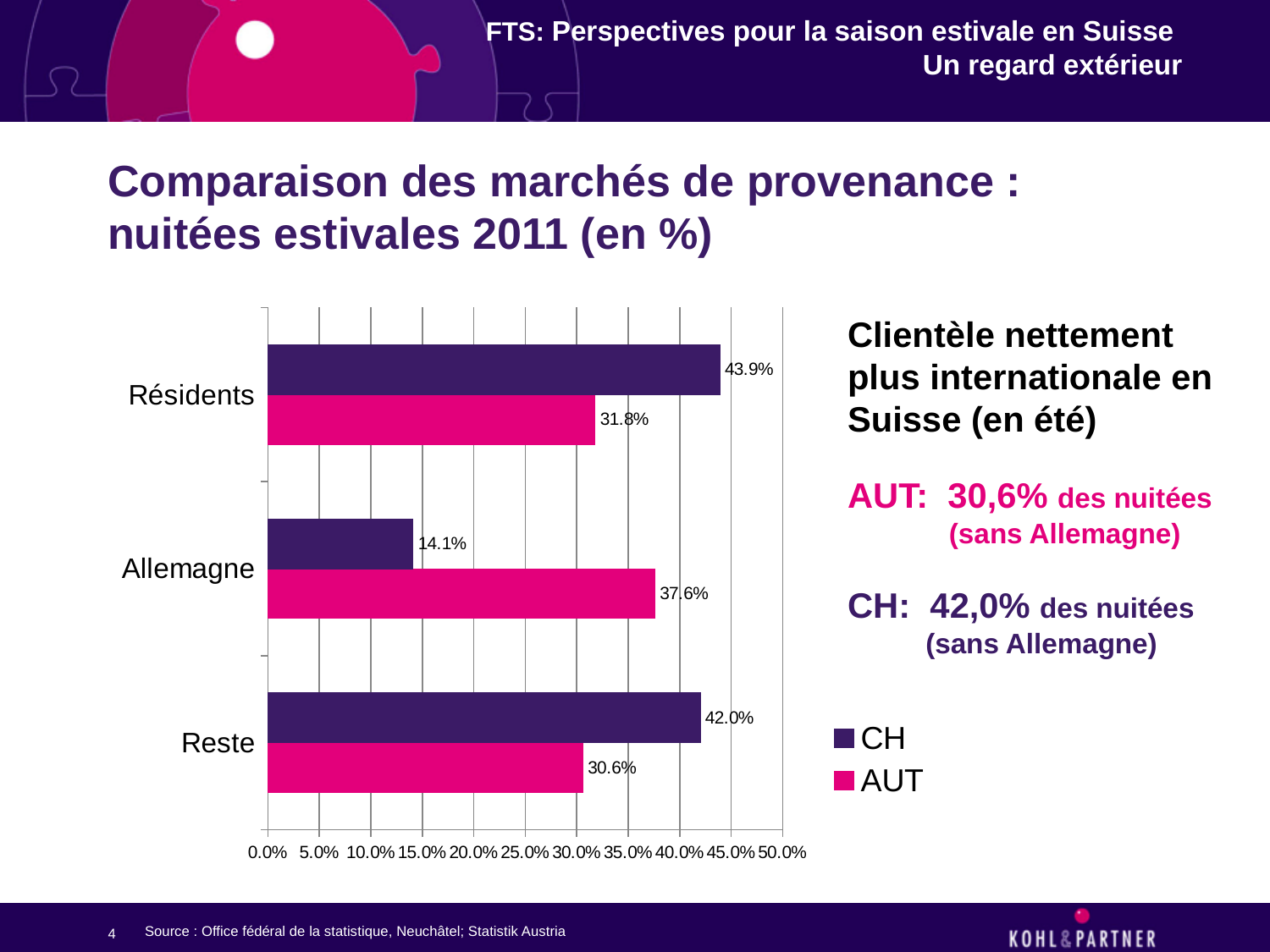
What is the AUT value for Reste? 30.6% What is the CH value for Résidents? 43.9% How many series does the legend list? 2 What is the difference between the CH and AUT values for Allemagne? 23.5% What kind of chart is shown on the slide? Bar chart Which category has the highest CH value? Résidents Which category has the lowest CH value? Allemagne How many categories are shown on the chart? 3 What is the CH value for Allemagne? 14.1% Which is larger for Résidents, the CH value or the AUT value? CH Which category has the lowest AUT value? Reste What is the AUT value for Allemagne? 37.6%